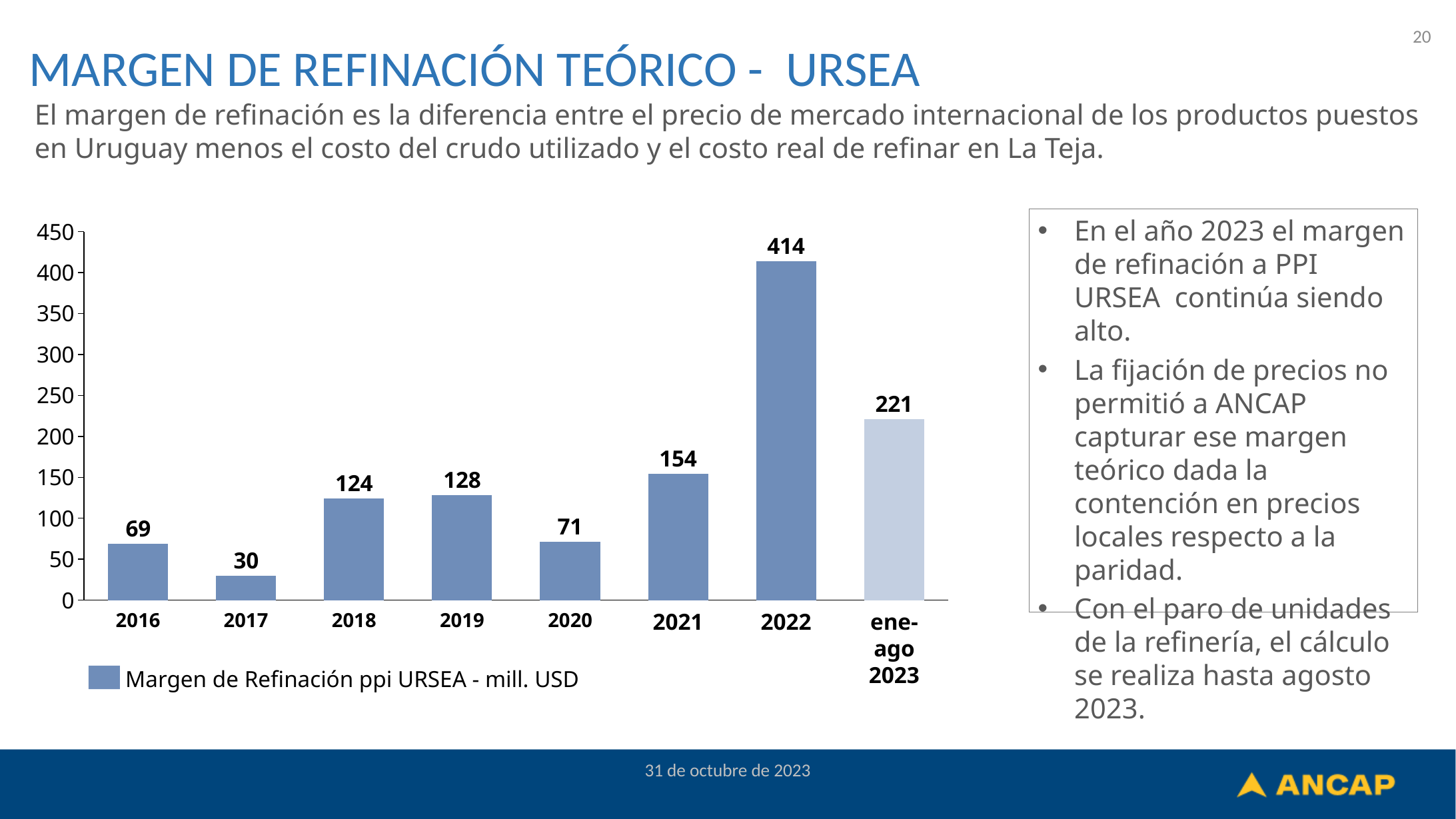
What is the value for 2022? 414 Which year has the highest value? 2022 What is the difference between the values for 2022 and 2021? 260 What is the value for ene-ago 2023? 221 Which is larger, the value for 2020 or the value for 2016? 2020 What kind of chart is this? bar chart What is the value for 2017? 30 Is the value for 2021 greater or less than 150? greater How many categories are shown on the x axis? 8 What is the difference between the values for 2019 and 2018? 4 Which year has the lowest value? 2017 What is the legend entry for the series? Margen de Refinación ppi URSEA - mill. USD